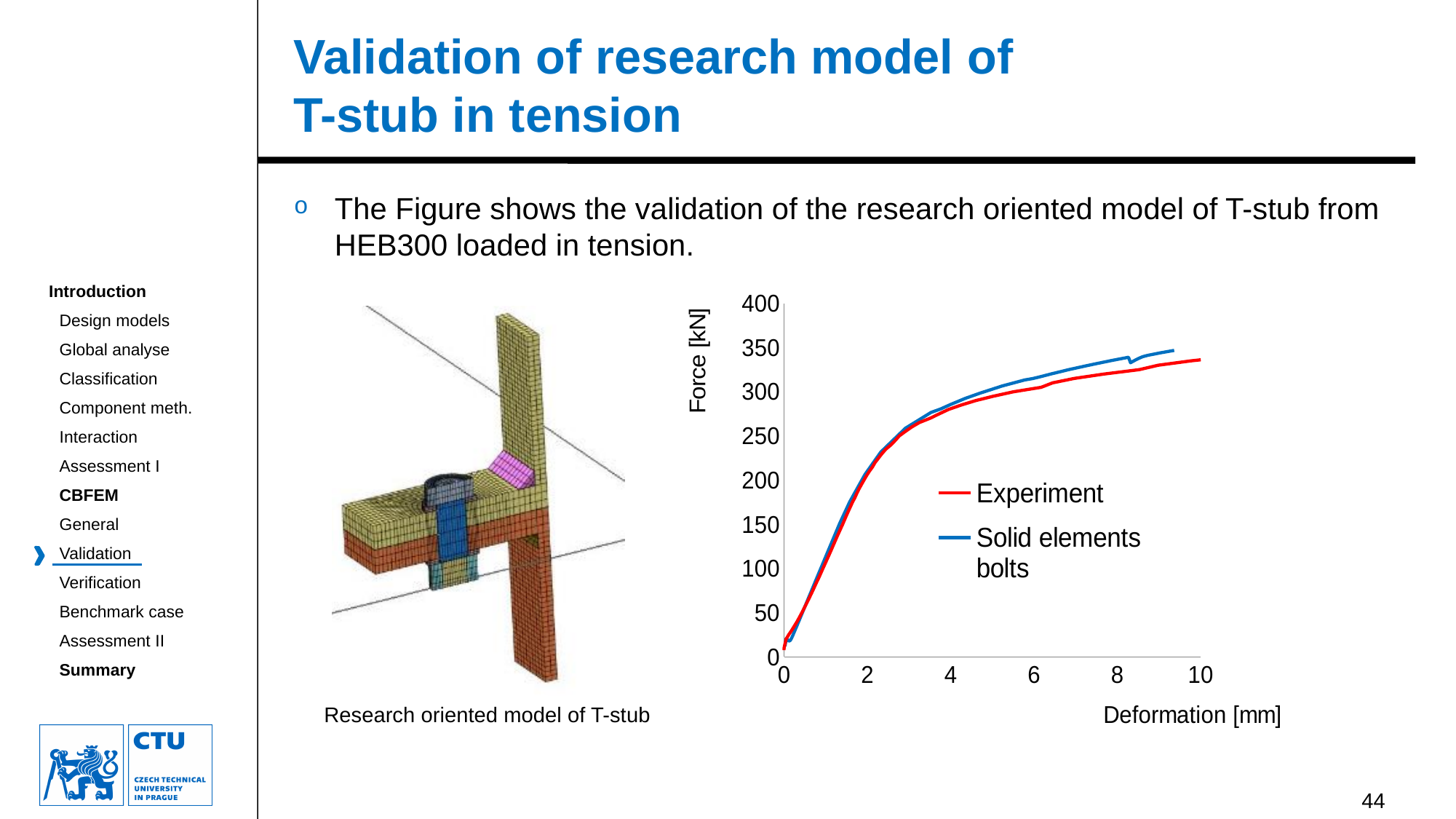
Is the force for the Solid elements bolts series at a deformation of 4 mm greater or less than 250 kN? greater Is the force for the Experiment series at a deformation of 2 mm greater or less than 100 kN? greater Is the highest force reached by the Experiment series greater or less than 350 kN? less How many series does the chart legend list? 2 What is the label of the vertical axis of the chart? Force [kN] What kind of chart is shown on the slide? line chart Does the force for the Solid elements bolts series rise or fall as deformation increases? rise Does the force for the Experiment series rise or fall as deformation increases? rise At a deformation of 8 mm, which series shows the higher force, Experiment or Solid elements bolts? Solid elements bolts What colour is the Experiment line in the chart? red